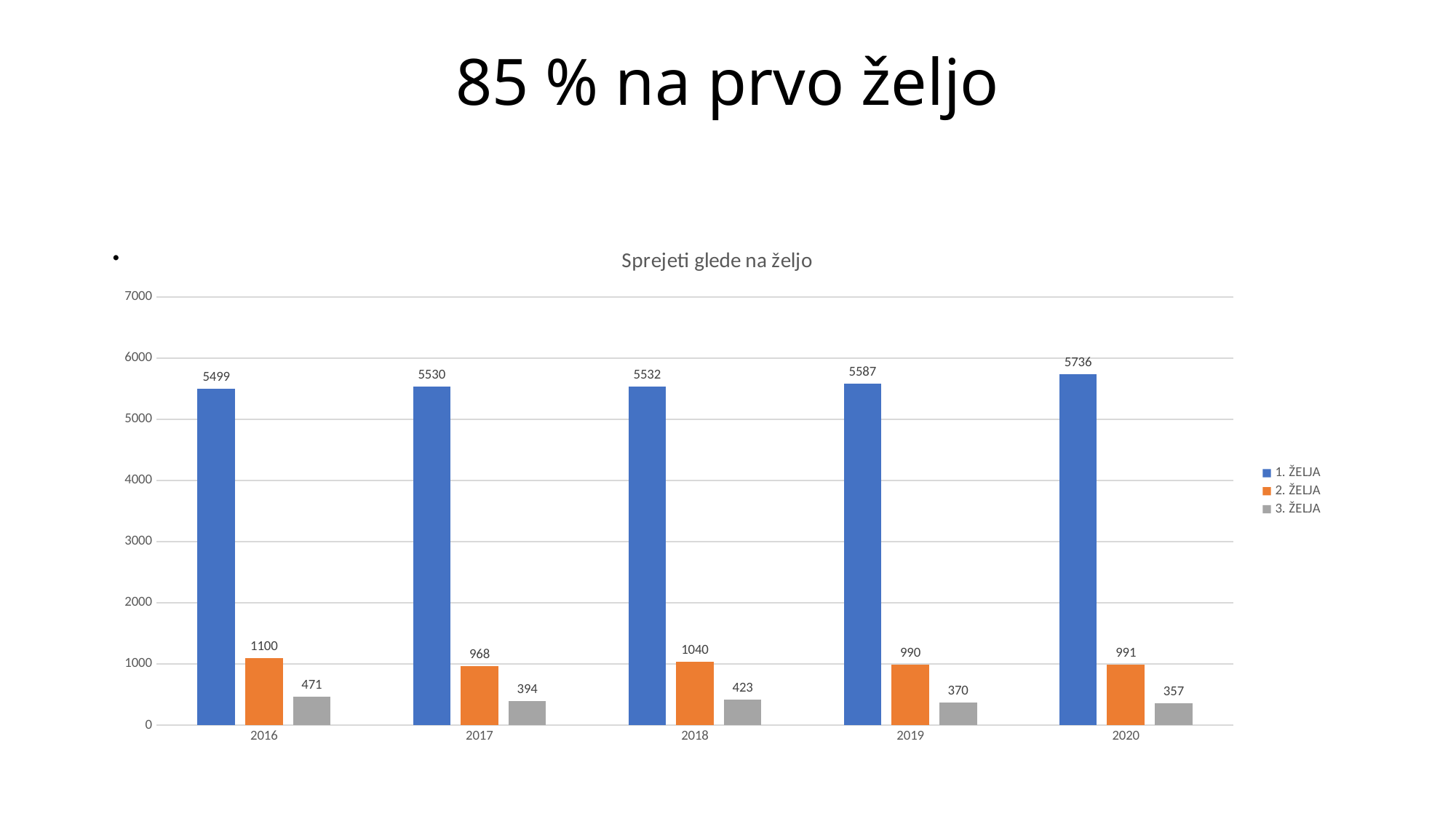
What is the value for 2. ŽELJA in 2016? 1100 What is the value for 3. ŽELJA in 2019? 370 Is the value for 1. ŽELJA in 2019 greater or less than 5000? greater What is the title of the chart? Sprejeti glede na željo In which year is the value for 1. ŽELJA highest? 2020 How many series does the legend list? 3 How many years are shown on the x axis? 5 What is the value for 1. ŽELJA in 2020? 5736 In which year is the value for 3. ŽELJA lowest? 2020 What is the difference between the 1. ŽELJA values for 2020 and 2016? 237 What kind of chart is shown on the slide? bar chart Which is larger, the 2. ŽELJA value for 2017 or for 2018? 2018